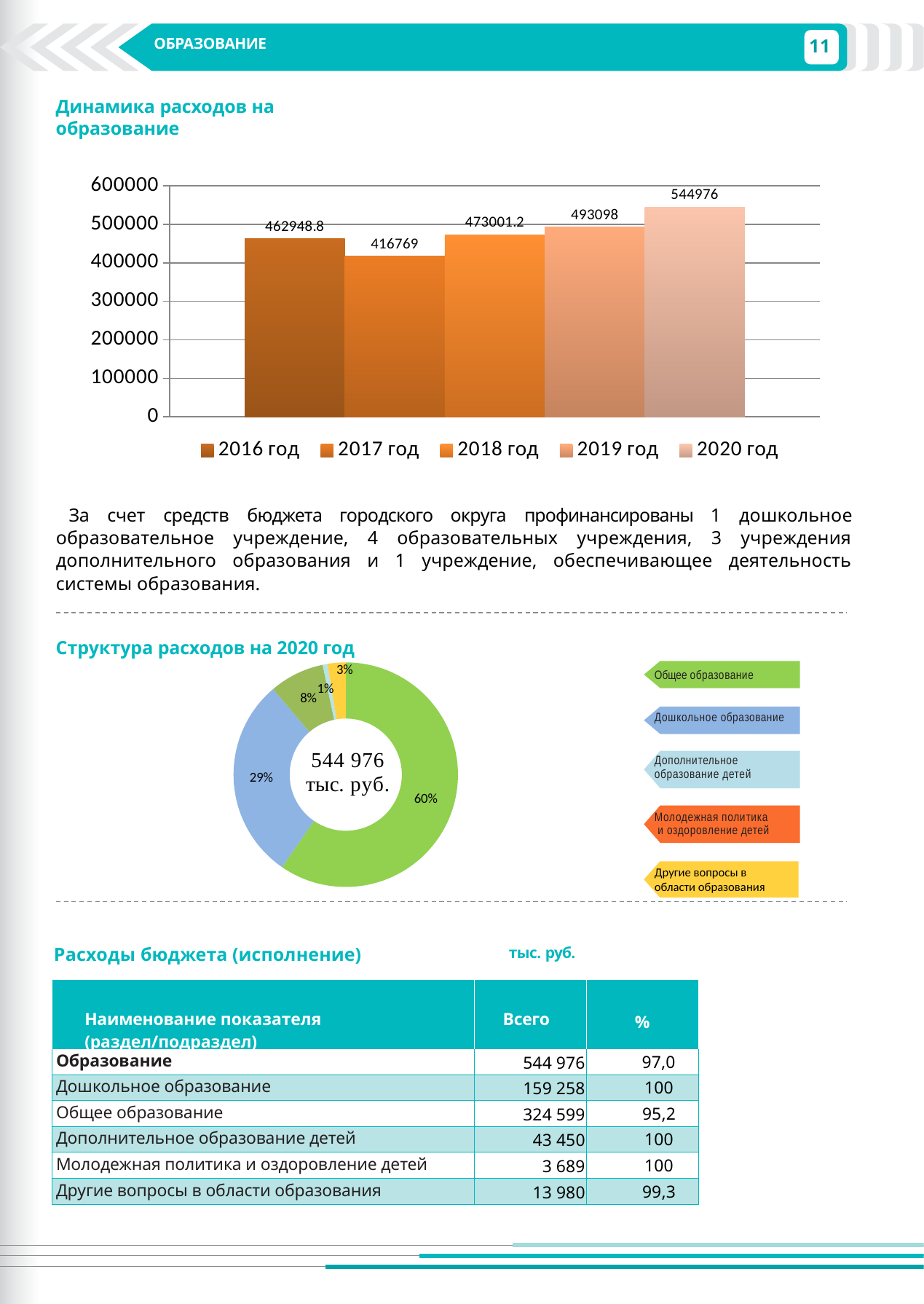
How many years are shown in the bar chart 'Динамика расходов на образование'? 5 In the bar chart 'Динамика расходов на образование', what is the value for 2017 год? 416769 In the doughnut chart 'Структура расходов на 2020 год', what share does Дошкольное образование have? 29% What kind of chart is 'Структура расходов на 2020 год'? doughnut chart In the doughnut chart 'Структура расходов на 2020 год', what share does Общее образование have? 60% In the bar chart 'Динамика расходов на образование', is the value for 2020 год greater or less than 500000? greater In the bar chart 'Динамика расходов на образование', what is the value for 2020 год? 544976 In the bar chart 'Динамика расходов на образование', which is larger: the value for 2016 год or 2018 год? 2018 год In the bar chart 'Динамика расходов на образование', which year has the lowest value? 2017 год In the bar chart 'Динамика расходов на образование', what is the difference between the values for 2020 год and 2019 год? 51878 In the bar chart 'Динамика расходов на образование', do the values rise or fall from 2017 год to 2020 год? rise In the bar chart 'Динамика расходов на образование', which year has the highest value? 2020 год